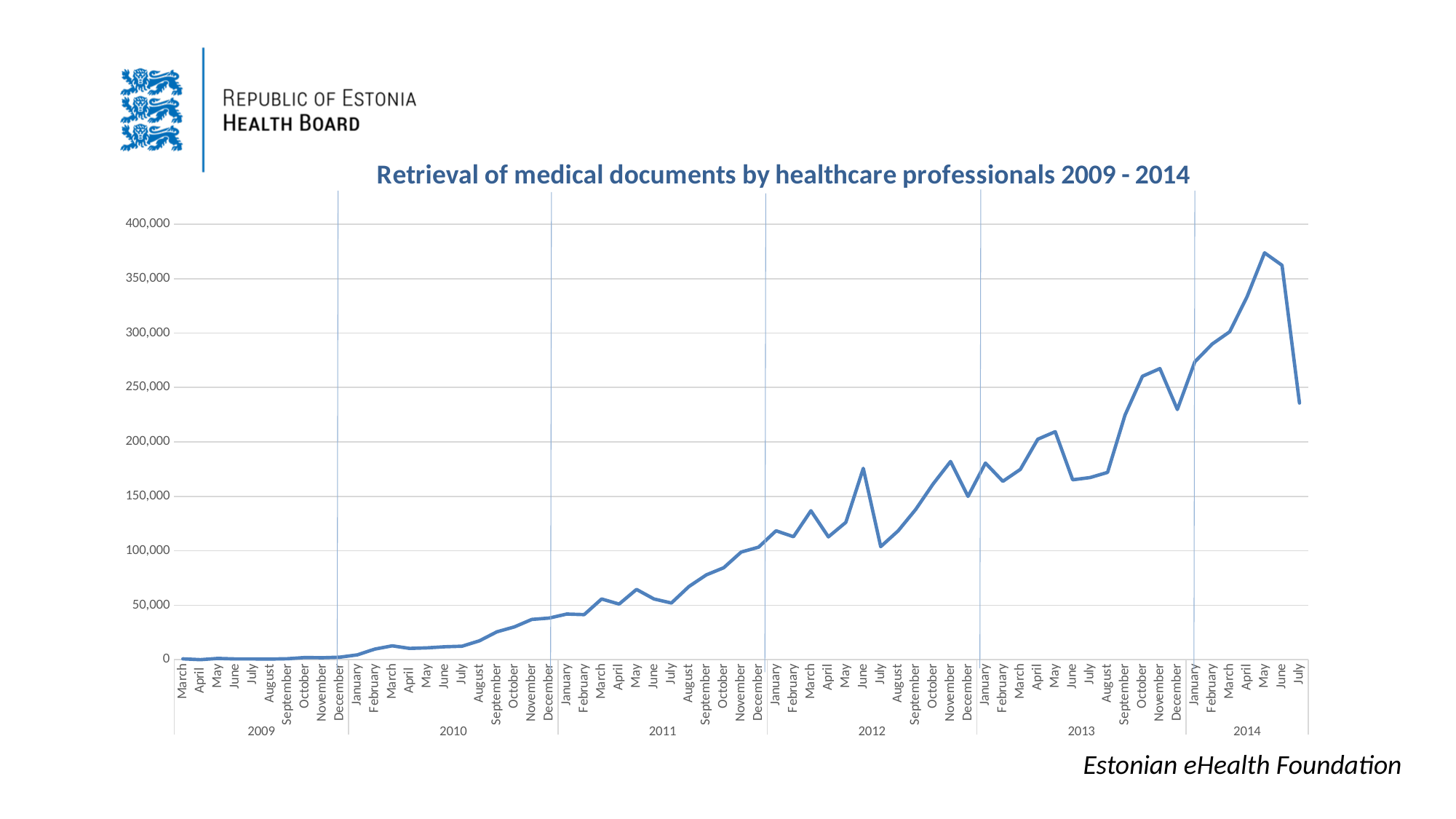
Is the value for June 2012 greater or less than 150,000? greater Which is larger, the value for November 2013 or the value for December 2013? November 2013 Overall, do the values rise or fall from 2009 to 2014? rise What kind of chart is shown on the slide? line chart In which month and year does the line reach its highest point? May 2014 What is the title of the chart? Retrieval of medical documents by healthcare professionals 2009 - 2014 Is the value for April 2014 greater or less than 300,000? greater Which is larger, the value for June 2012 or the value for July 2012? June 2012 Is the value for July 2014 greater or less than 250,000? less How many years are labelled along the x axis? 6